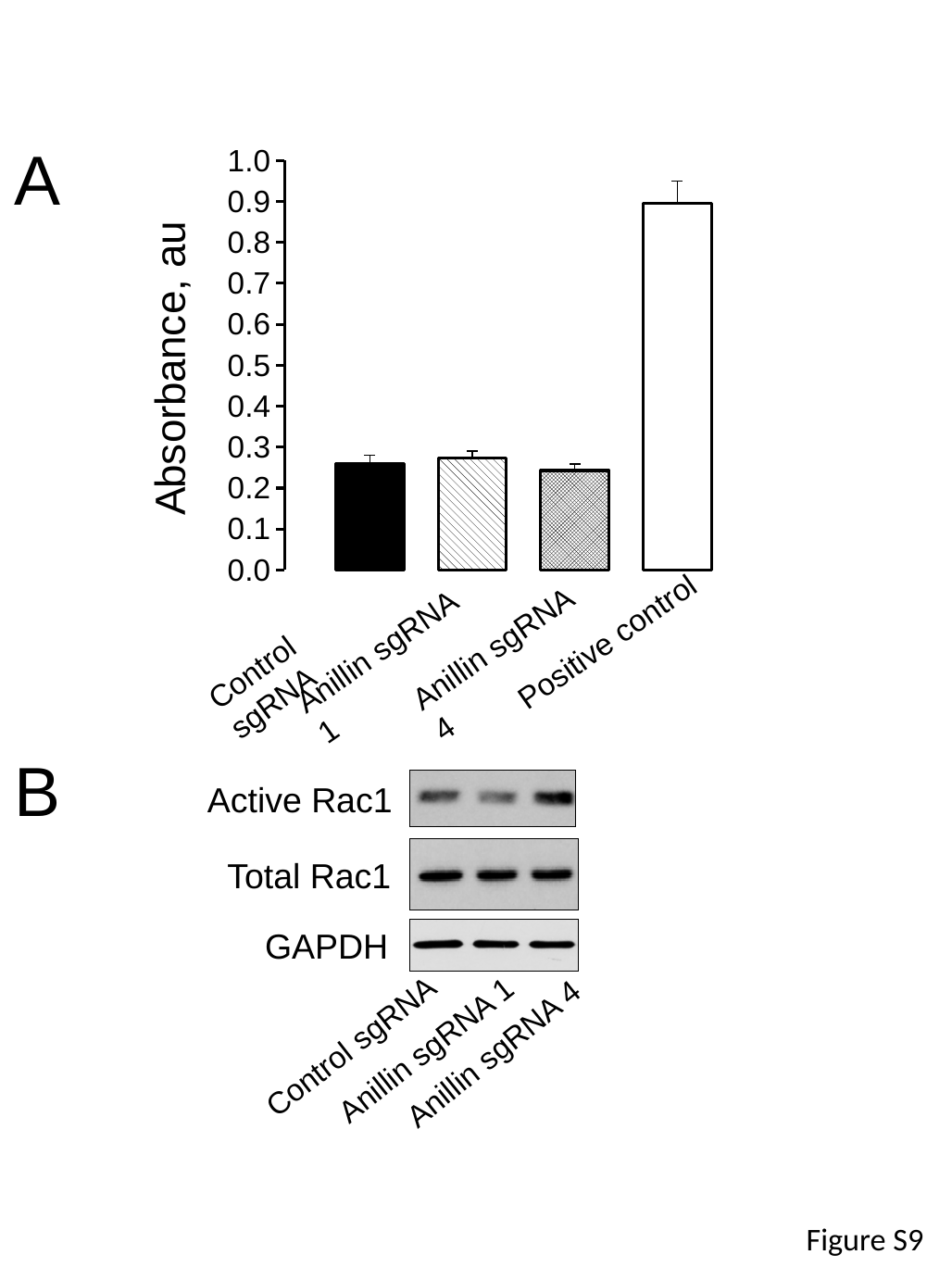
In panel A, which is larger, the value for Positive control or the value for Anillin sgRNA 1? Positive control In panel A, which is larger, the value for Control sgRNA or the value for Positive control? Positive control In panel A, which category has the highest absorbance? Positive control In panel A, is the value for Positive control greater or less than 0.8? greater In panel A, how many bars (categories) are plotted? 4 In panel A, is the value for Anillin sgRNA 4 greater or less than 0.3? less In panel A, is the value for Control sgRNA greater or less than 0.2? greater In panel A, what is the maximum value shown on the y axis? 1.0 In panel A, what kind of chart is shown? bar chart In panel A, what is the label of the y axis? Absorbance, au